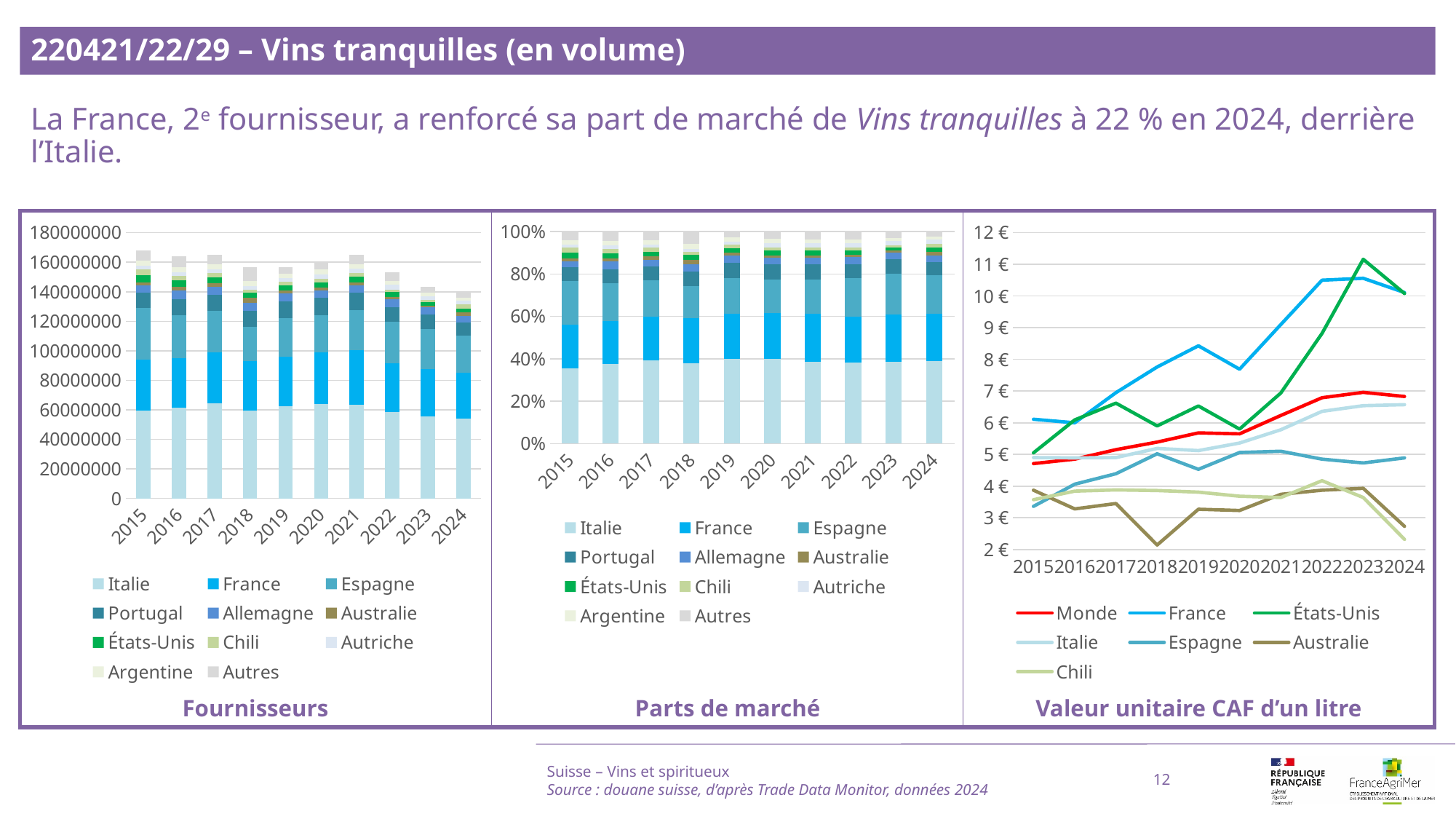
In the 'Valeur unitaire CAF d'un litre' chart, which series has the lowest value in 2018? Australie How many years are shown on the x axis of the 'Parts de marché' chart? 10 What kind of chart is the 'Fournisseurs' chart on the left? Stacked bar chart In the 'Valeur unitaire CAF d'un litre' chart, which series reaches the highest value in 2023? États-Unis In the 'Valeur unitaire CAF d'un litre' chart, which is higher in 2024: France or Italie? France In the 'Fournisseurs' chart, is the total height of the 2015 bar greater or less than 160000000? greater How many series does the legend of the 'Valeur unitaire CAF d'un litre' chart list? 7 In the 'Fournisseurs' chart, is the total height of the 2024 bar greater or less than 160000000? less How many series does the legend of the 'Fournisseurs' chart list? 11 In the 'Valeur unitaire CAF d'un litre' chart, does the France line generally rise or fall from 2015 to 2024? rise In the 'Fournisseurs' chart, do the total bar heights generally rise or fall from 2015 to 2024? fall In the 'Valeur unitaire CAF d'un litre' chart, is the value for France in 2024 greater or less than 9 €? greater